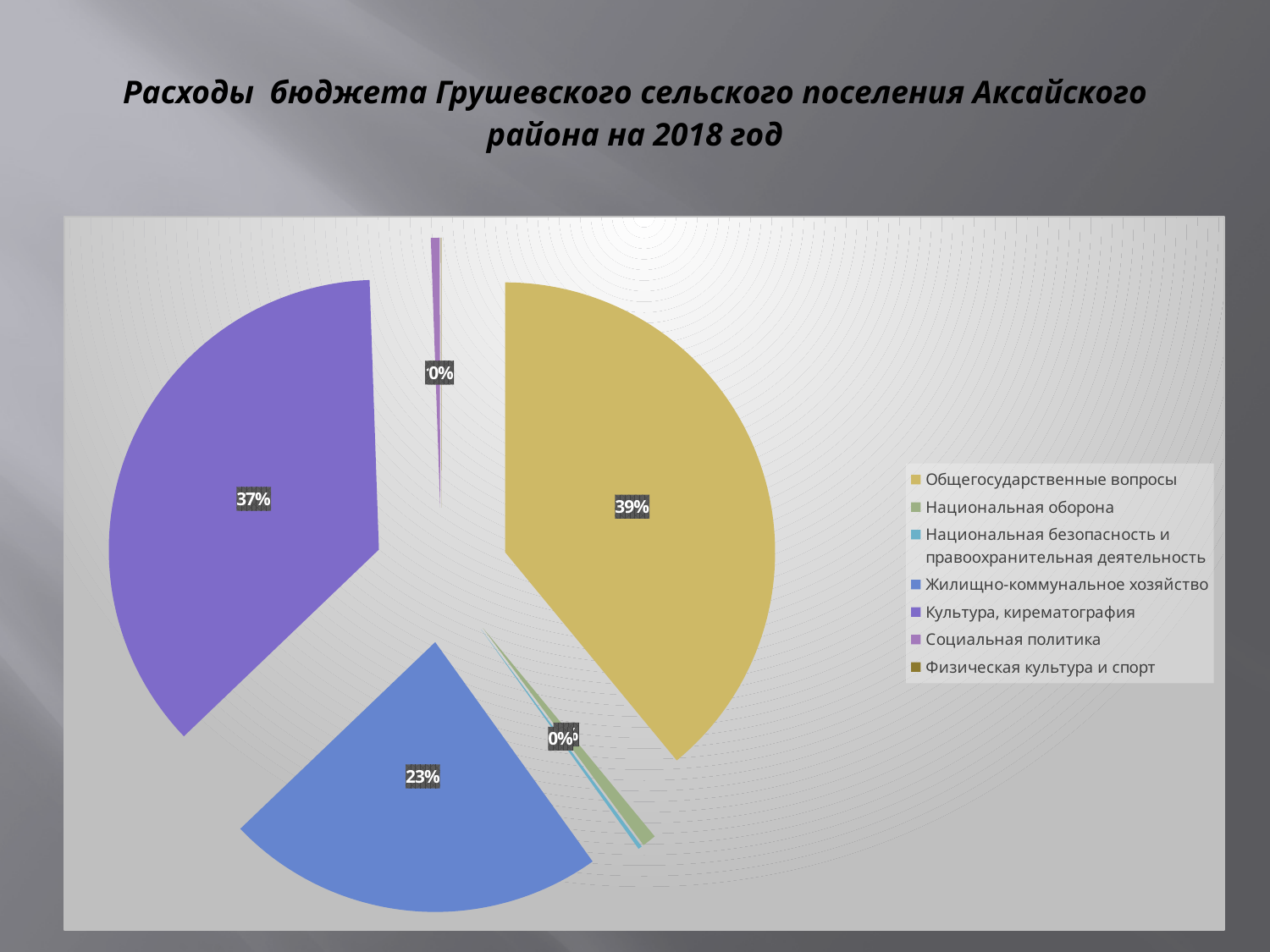
What is the difference in percentage points between the Культура, кирематография slice and the Жилищно-коммунальное хозяйство slice? 14 Which category has the largest slice of the pie? Общегосударственные вопросы What kind of chart is shown on the slide? pie chart How many categories does the legend list? 7 Which is larger, the slice for Культура, кирематография or the slice for Жилищно-коммунальное хозяйство? Культура, кирематография What colour is the slice for Жилищно-коммунальное хозяйство? blue What share of the pie does Культура, кирематография take? 37% What share of the pie does Жилищно-коммунальное хозяйство take? 23% What is the title of the slide? Расходы бюджета Грушевского сельского поселения Аксайского района на 2018 год What is the difference in percentage points between the Общегосударственные вопросы slice and the Жилищно-коммунальное хозяйство slice? 16 Which is larger, the slice for Общегосударственные вопросы or the slice for Культура, кирематография? Общегосударственные вопросы What share of the pie does Общегосударственные вопросы take? 39%